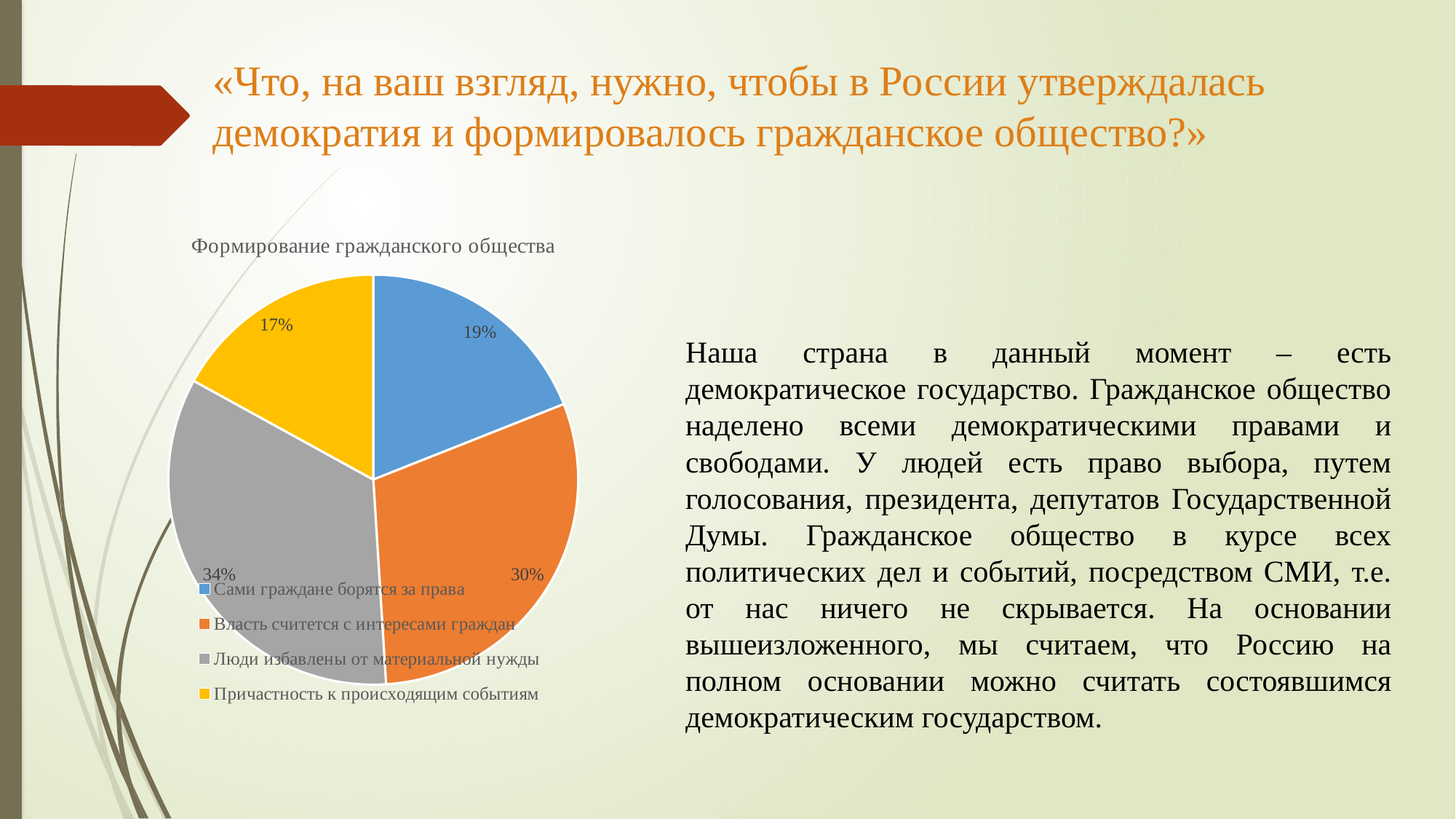
Which category has the largest share of the pie? Люди избавлены от материальной нужды Which category has the smallest share of the pie? Причастность к происходящим событиям What percentage is shown for "Сами граждане борятся за права"? 19% What is the title of the chart? Формирование гражданского общества What percentage is shown for "Люди избавлены от материальной нужды"? 34% What percentage is shown for "Власть считется с интересами граждан"? 30% What is the difference between the shares for "Люди избавлены от материальной нужды" and "Сами граждане борятся за права"? 15% What colour is the slice for "Люди избавлены от материальной нужды"? grey What type of chart is shown on the slide? pie chart What percentage is shown for "Причастность к происходящим событиям"? 17% How many categories does the pie chart have? 4 Which is larger: the share for "Власть считется с интересами граждан" or for "Причастность к происходящим событиям"? Власть считется с интересами граждан